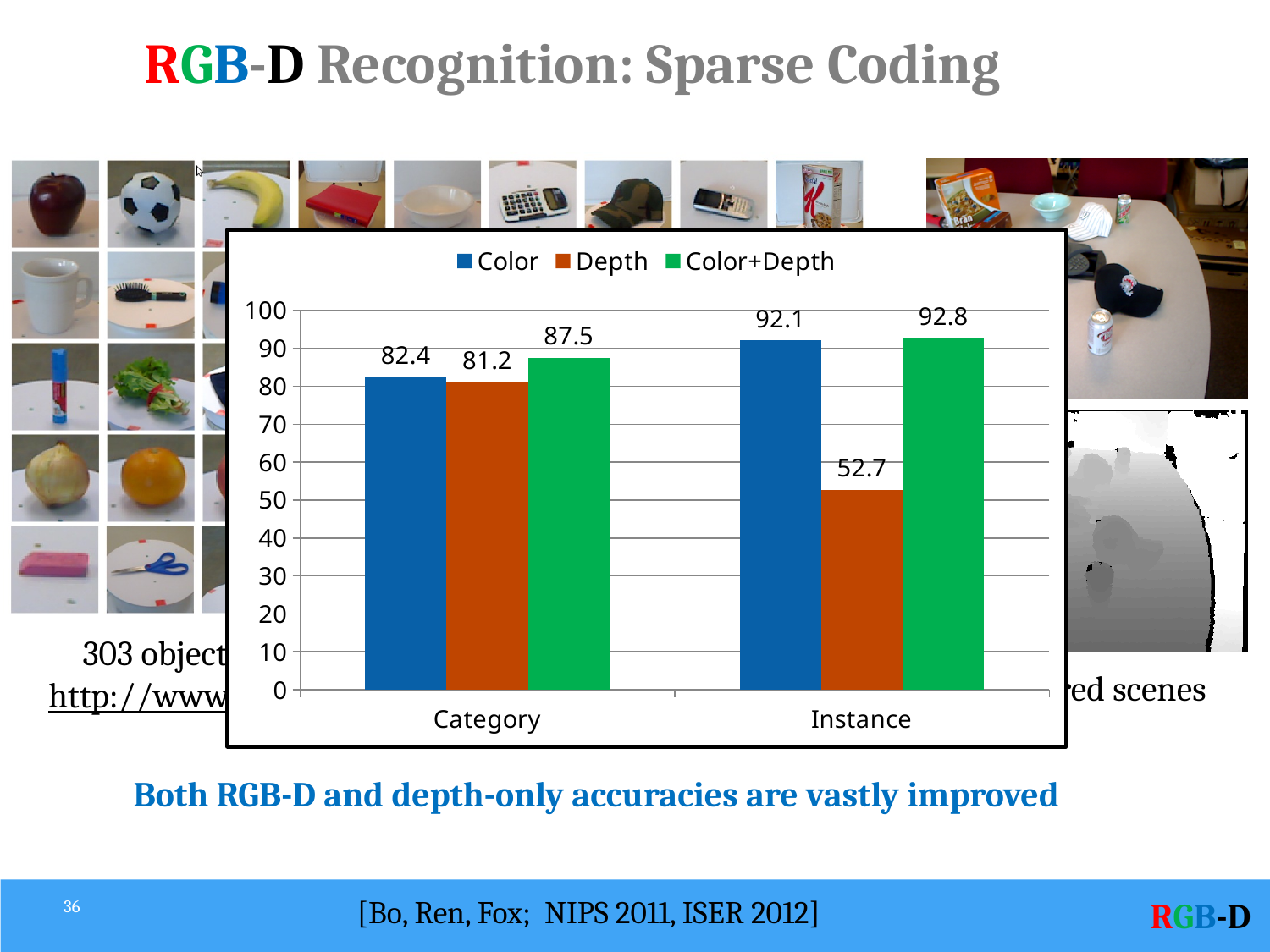
What is the Color value for Category? 82.4 How many series does the legend list? 3 What is the difference between the Color+Depth and Color values for Category? 5.1 What is the Depth value for Instance? 52.7 What is the Depth value for Category? 81.2 How many categories are shown on the x axis? 2 What is the difference between the Color+Depth and Depth values for Instance? 40.1 Which series has the highest value for Category? Color+Depth What kind of chart is shown? bar chart What is the Color+Depth value for Instance? 92.8 Which is larger, the Color value for Instance or the Color value for Category? Instance Which series has the lowest value for Instance? Depth